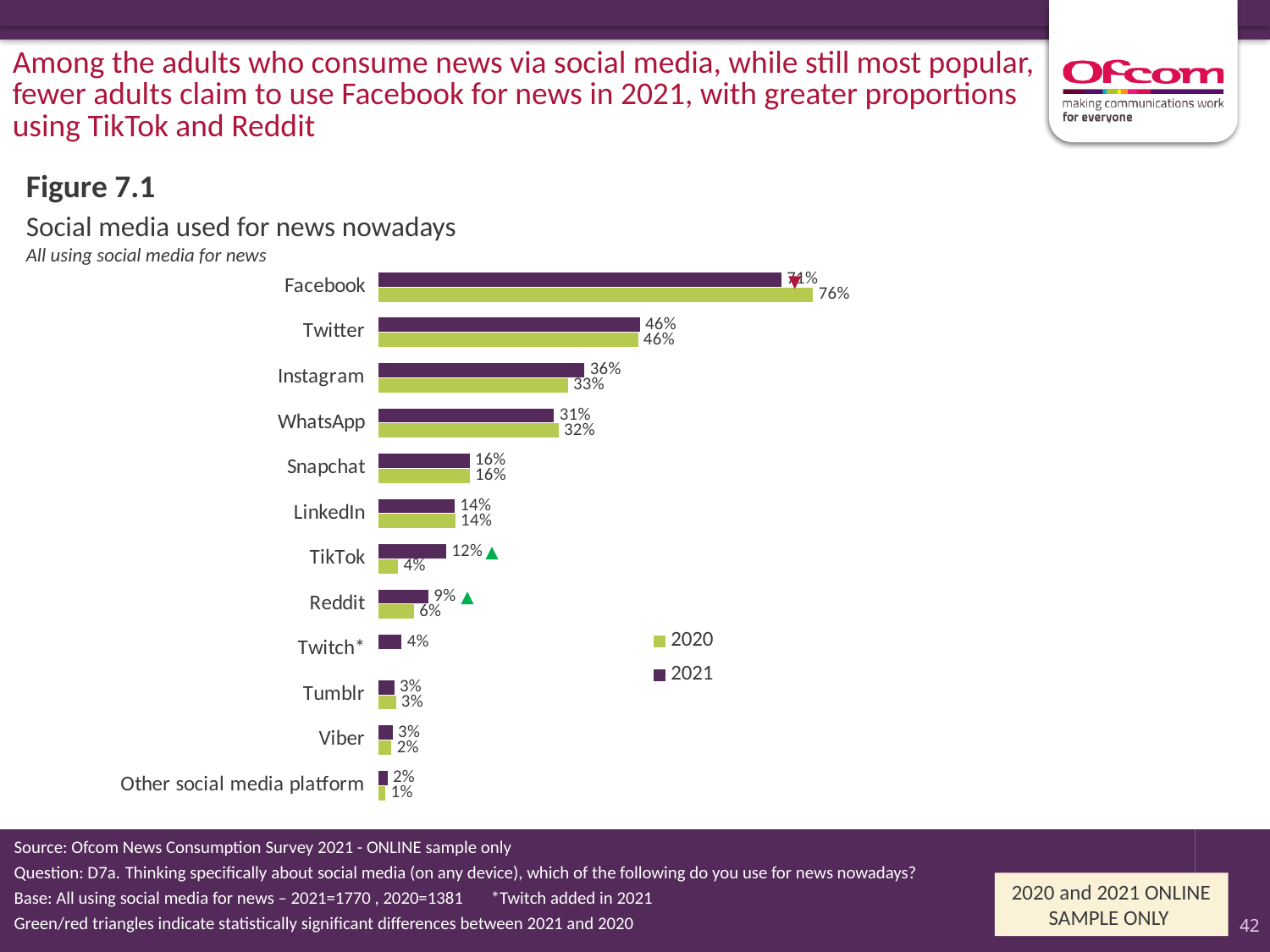
What percentage used Facebook for news in 2020? 76% What is the difference between the 2021 and 2020 percentages for TikTok? 8% What kind of chart is shown on the slide? Bar chart Which social media platform has the highest percentage for news in 2020? Facebook Which platform was added to the survey in 2021 and has no 2020 value? Twitch How many series does the legend list? 2 Which is larger, the 2021 percentage for WhatsApp or the 2020 percentage for WhatsApp? 2020 What percentage used Reddit for news in 2020? 6% What percentage used Instagram for news in 2021? 36% What percentage used TikTok for news in 2021? 12% Which category has the lowest percentage for news in 2020? Other social media platform How many social media categories are shown on the chart? 12